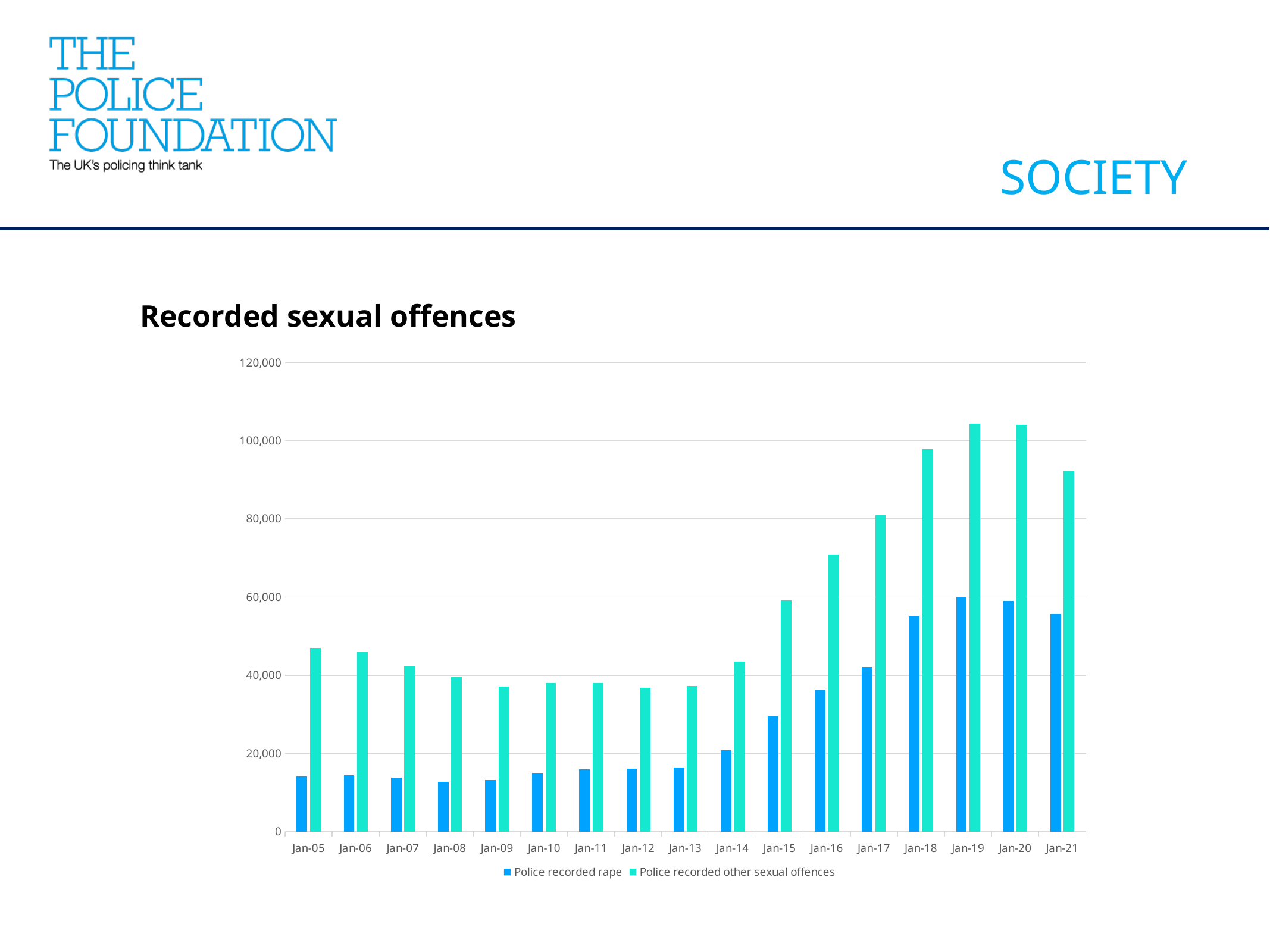
Overall, does the Police recorded rape series rise or fall from Jan-05 to Jan-21? rise Which series is shown in the lighter turquoise bars? Police recorded other sexual offences At Jan-21, which series has the larger value: Police recorded rape or Police recorded other sexual offences? Police recorded other sexual offences Is the value for Police recorded rape at Jan-05 greater or less than 20,000? less Is the value for Police recorded rape at Jan-15 greater or less than 20,000? greater How many time points are shown on the x axis? 17 What kind of chart is shown on the slide? bar chart How many series does the legend list? 2 Is the value for Police recorded other sexual offences at Jan-21 greater or less than 80,000? greater Which is larger: Police recorded other sexual offences at Jan-05 or at Jan-21? Jan-21 What is the title of the chart? Recorded sexual offences